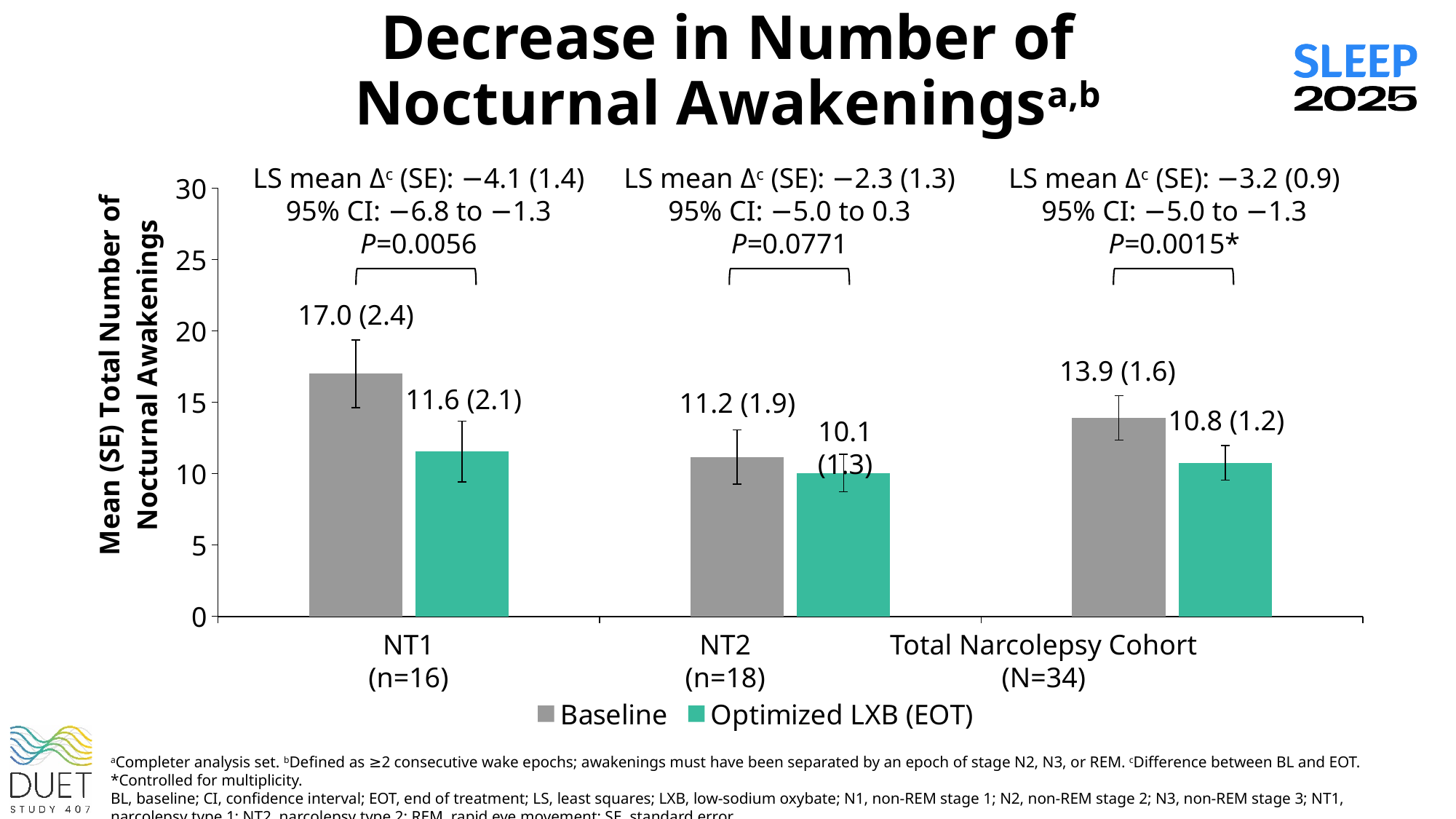
Which is larger, the Baseline mean for NT2 (n=18) or the Baseline mean for the Total Narcolepsy Cohort (N=34)? Total Narcolepsy Cohort (N=34) What is the mean (SE) total number of nocturnal awakenings at Baseline for NT1 (n=16)? 17.0 (2.4) Which group and series has the highest mean number of nocturnal awakenings? NT1 Baseline What kind of chart is shown on the slide? Bar chart Which group has the lowest Optimized LXB (EOT) mean value? NT2 (n=18) How many series does the legend list? 2 How many groups are shown on the x axis? 3 What is the mean total number of nocturnal awakenings for Optimized LXB (EOT) in the Total Narcolepsy Cohort (N=34)? 10.8 What is the mean (SE) value for Optimized LXB (EOT) in the NT2 (n=18) group? 10.1 (1.3) Is the Baseline mean value for NT1 (n=16) greater or less than 15? greater What is the difference between the Baseline and Optimized LXB (EOT) mean values for NT1 (n=16)? 5.4 What is the difference between the Baseline and Optimized LXB (EOT) mean values in the Total Narcolepsy Cohort (N=34)? 3.1